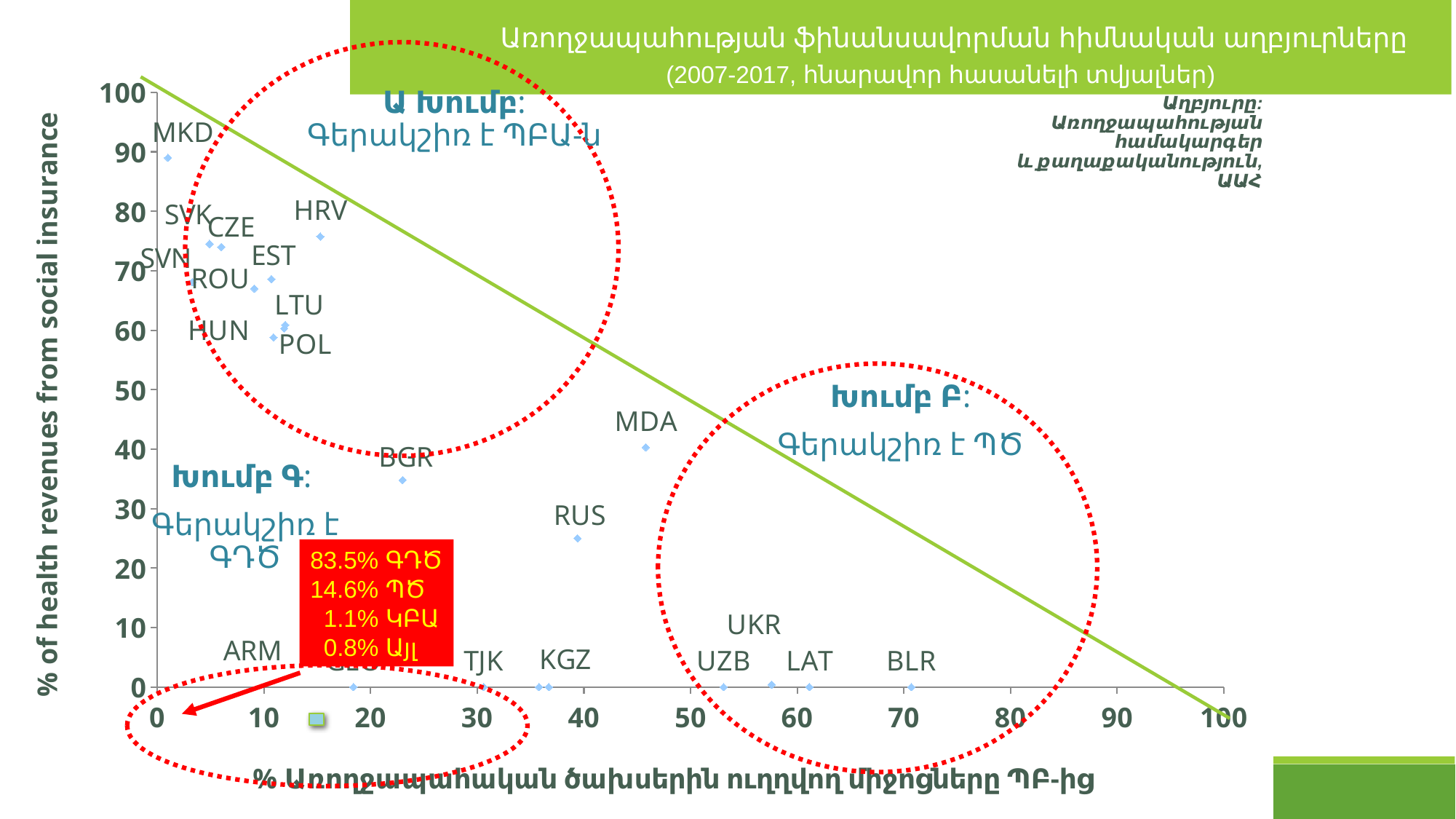
Which has a higher vertical-axis value, MKD or HRV? MKD Which has a higher vertical-axis value, BGR or RUS? BGR Is the horizontal-axis value for BLR greater or less than 60? greater What is the label of the vertical axis? % of health revenues from social insurance Is the vertical-axis value for MKD greater or less than 80? greater Is the horizontal-axis value for UKR greater or less than 50? greater What kind of chart is shown on the slide? scatter chart Which country has the highest value on the vertical axis (% of health revenues from social insurance)? MKD Which country is plotted furthest to the right on the horizontal axis? BLR